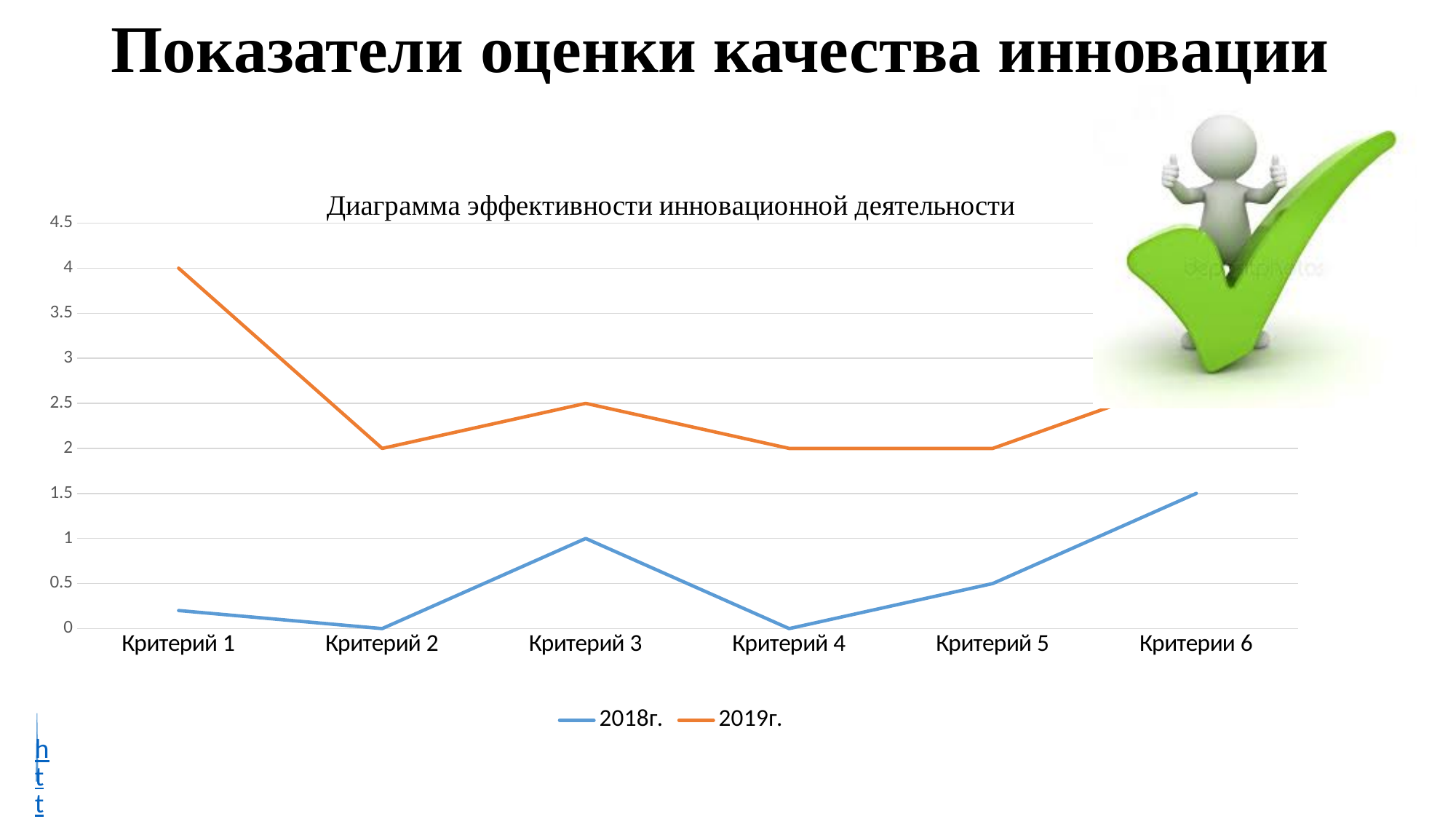
Which category has the highest value for 2019г.? Критерий 1 What kind of chart is shown on the slide? line chart What is the difference between the 2019г. values at Критерий 1 and Критерий 2? 2 What is the value for 2018г. at Критерий 5? 0.5 What is the value for 2019г. at Критерий 3? 2.5 How many series does the legend list? 2 Which category has the highest value for 2018г.? Критерии 6 What is the value for 2019г. at Критерий 1? 4 What is the value for 2018г. at Критерии 6? 1.5 Is the value for 2018г. at Критерий 1 greater or less than 0.5? less What is the title of the chart? Диаграмма эффективности инновационной деятельности How many categories are plotted along the x axis? 6